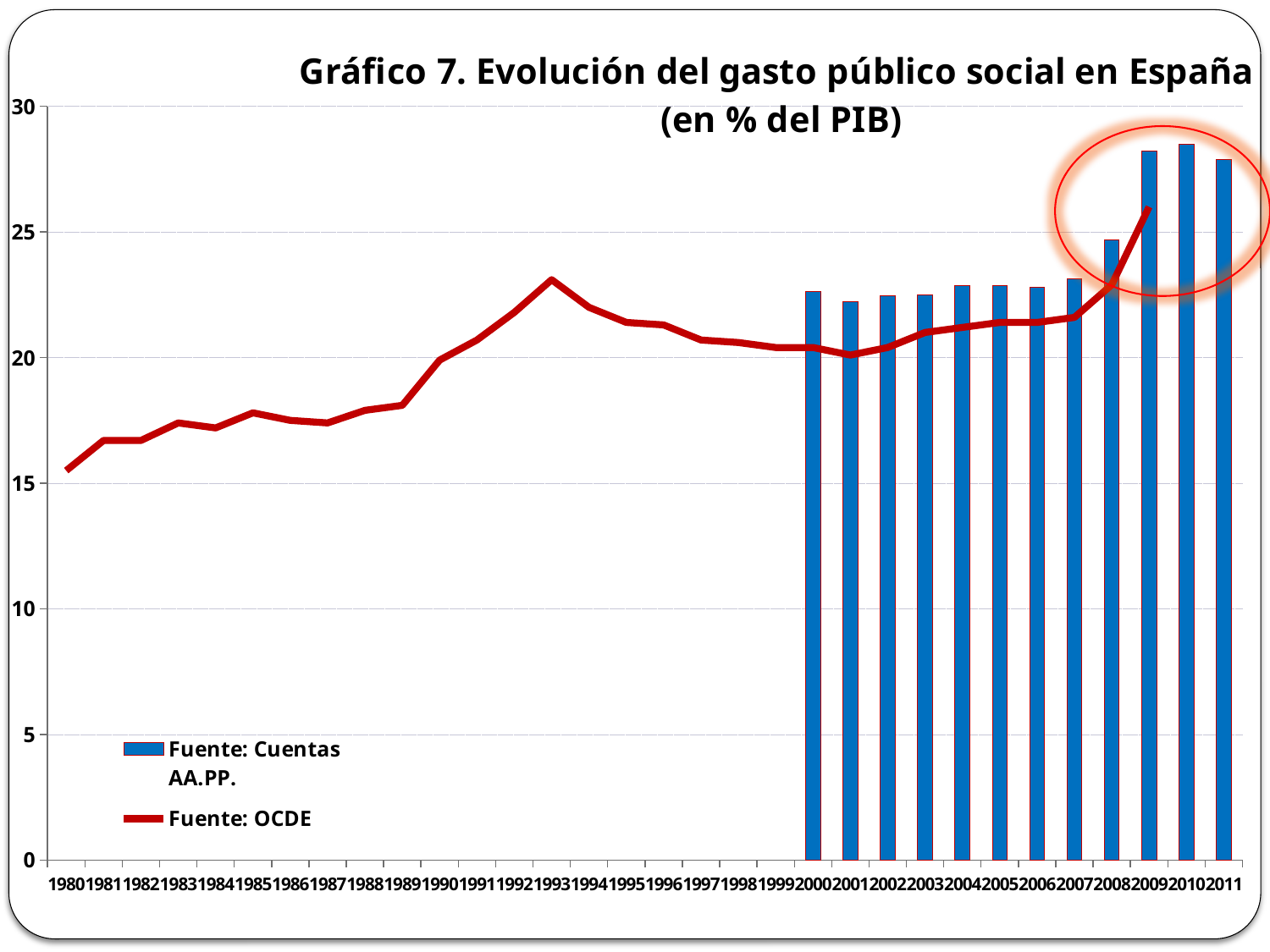
What are the two series named in the legend? Fuente: Cuentas AA.PP. and Fuente: OCDE In which year is the OCDE line at its lowest value? 1980 Is the OCDE line value for 1980 greater or less than 20? less How many series does the legend list? 2 What kind of chart is shown on the slide? A combined bar and line chart In which year does the OCDE line reach its highest value before 2000? 1993 Is the Cuentas AA.PP. bar for 2009 greater or less than 25? greater How many bars (Fuente: Cuentas AA.PP.) are plotted on the chart? 12 Which is larger, the Cuentas AA.PP. bar for 2011 or the bar for 2008? 2011 What is the title of the chart? Gráfico 7. Evolución del gasto público social en España (en % del PIB) How many years are shown on the x axis? 32 Is the Cuentas AA.PP. bar for 2008 greater or less than 25? less